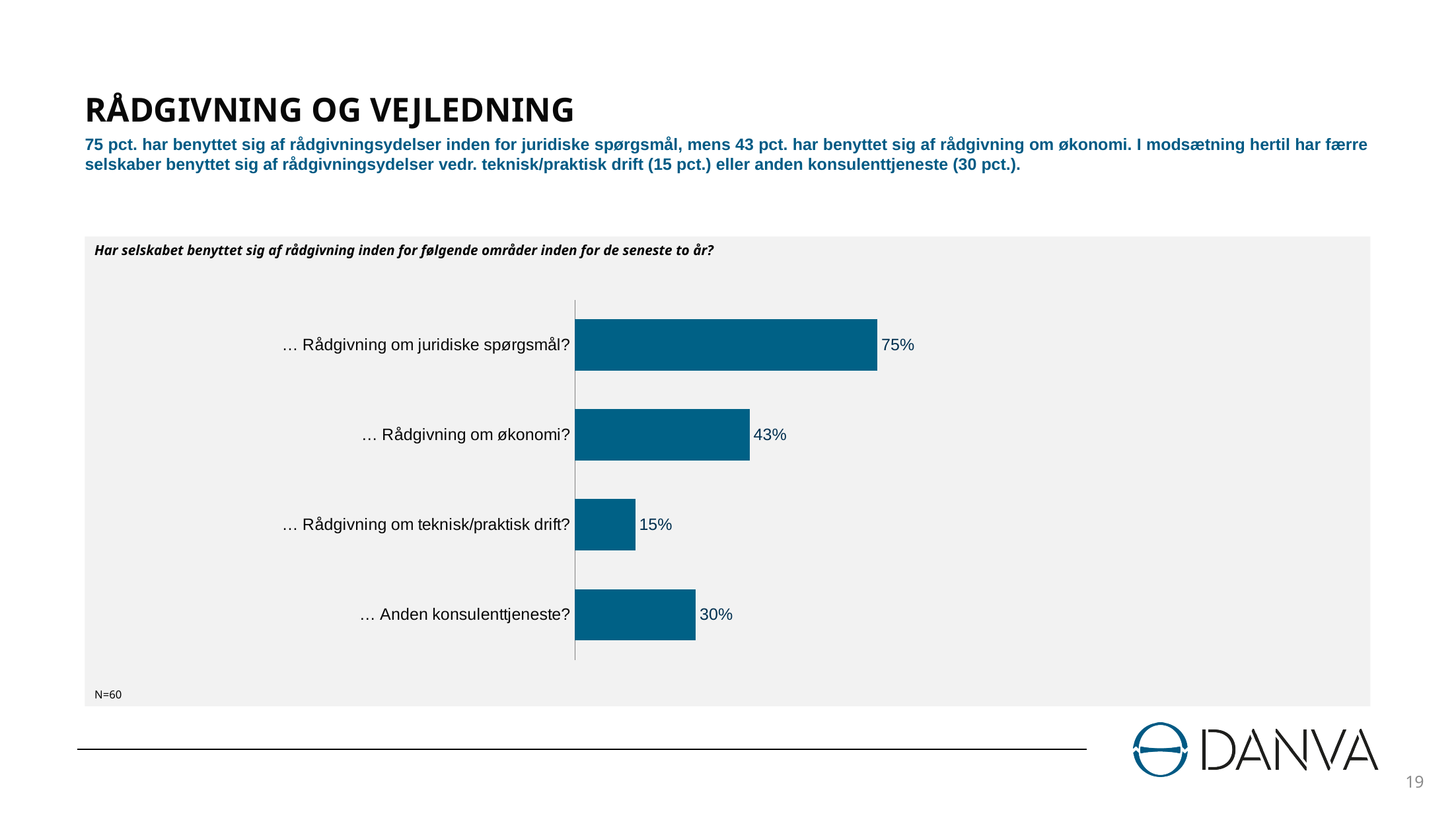
Which category has the lowest value? … Rådgivning om teknisk/praktisk drift? What is the value for "… Anden konsulenttjeneste?"? 30% Which category has the highest value? … Rådgivning om juridiske spørgsmål? What is the value for "… Rådgivning om økonomi?"? 43% What is the value for "… Rådgivning om juridiske spørgsmål?"? 75% What is the difference between the values for "… Rådgivning om juridiske spørgsmål?" and "… Rådgivning om økonomi?"? 32% What is the value for "… Rådgivning om teknisk/praktisk drift?"? 15% What is the difference between the values for "… Anden konsulenttjeneste?" and "… Rådgivning om teknisk/praktisk drift?"? 15% What is the sample size (N) stated below the chart? N=60 Which is larger, the value for "… Rådgivning om økonomi?" or the value for "… Anden konsulenttjeneste?"? … Rådgivning om økonomi? What kind of chart is shown on the slide? Bar chart How many categories are shown in the chart? 4